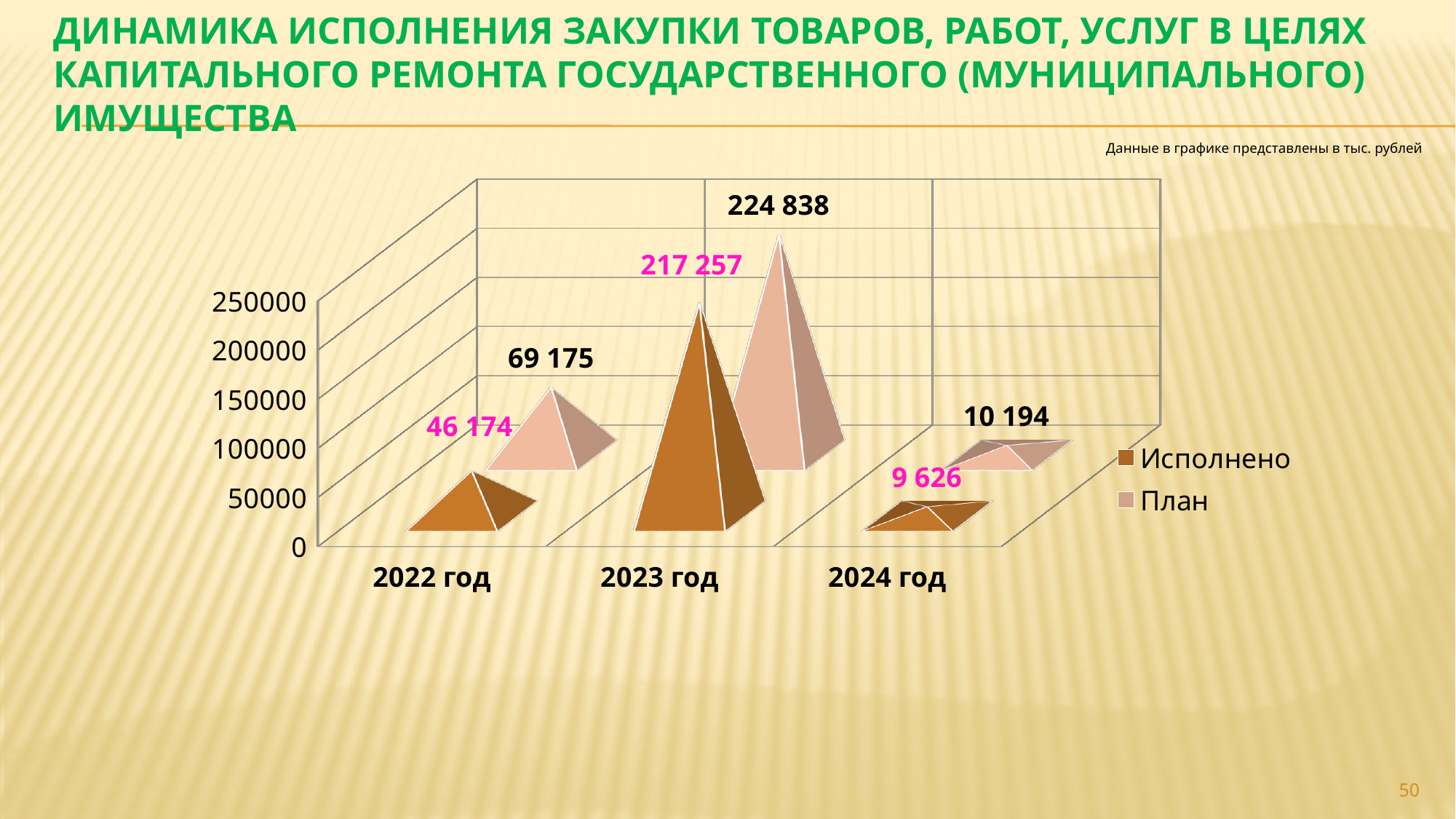
What is the value of План for 2023 год? 224 838 How many series does the legend list? 2 In what units are the data in the chart presented, according to the note on the slide? тыс. рублей Which year has the highest value for План? 2023 год How many years are shown on the x axis? 3 Which year has the lowest value for Исполнено? 2024 год What is the value of План for 2024 год? 10 194 What is the value of Исполнено for 2024 год? 9 626 What is the value of Исполнено for 2022 год? 46 174 Which is larger for 2022 год, Исполнено or План? План What is the difference between План and Исполнено for 2022 год? 23 001 What is the difference between План and Исполнено for 2023 год? 7 581